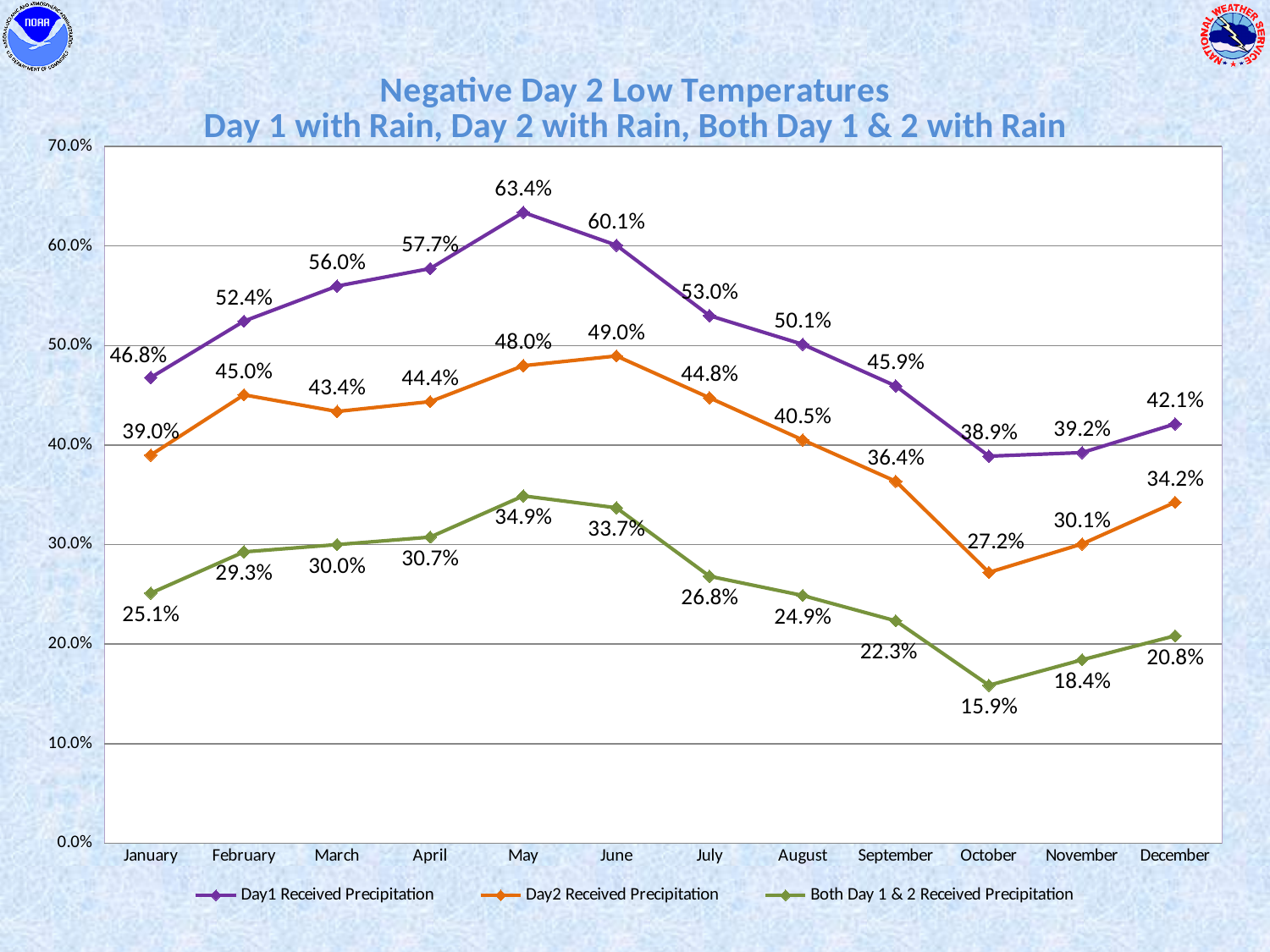
How many months are shown on the x axis? 12 What is the difference between Day1 Received Precipitation and Day2 Received Precipitation in June? 11.1% How many series does the legend list? 3 Which is larger in September: Day2 Received Precipitation or Both Day 1 & 2 Received Precipitation? Day2 Received Precipitation What is the value for Both Day 1 & 2 Received Precipitation in December? 20.8% Is the value for Day1 Received Precipitation in October greater or less than 40.0%? less What is the value for Day1 Received Precipitation in May? 63.4% What is the value for Day2 Received Precipitation in October? 27.2% What kind of chart is shown on the slide? line chart Does Day2 Received Precipitation rise or fall from June to October? fall In which month is Day1 Received Precipitation highest? May In which month is Both Day 1 & 2 Received Precipitation lowest? October